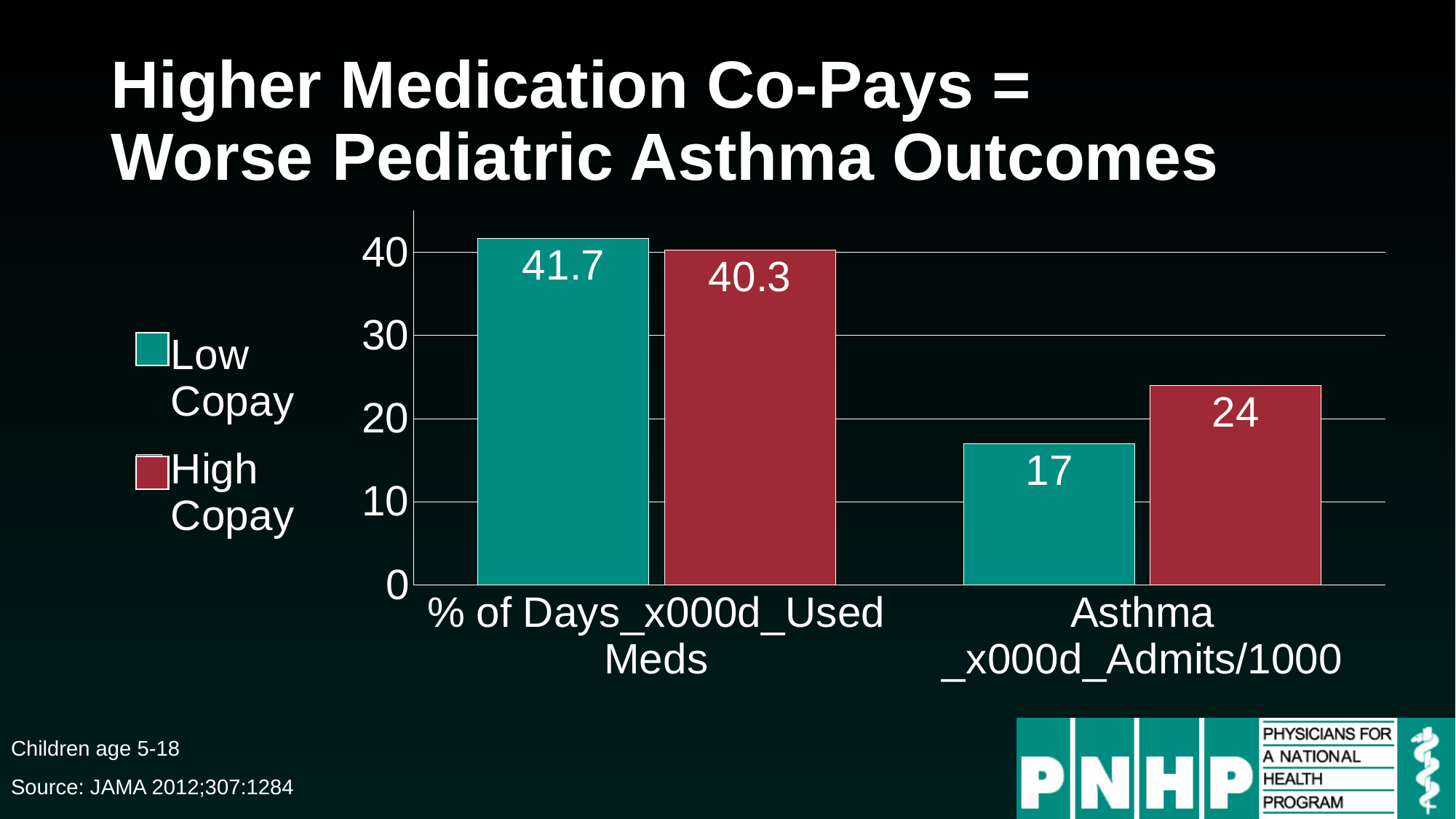
Which bar in the chart has the highest value? Low Copay, % of Days Used Meds (41.7) What is the difference between the Low Copay and High Copay values for % of Days Used Meds? 1.4 What colour represents the High Copay series? Red Which bar in the chart has the lowest value? Low Copay, Asthma Admits/1000 (17) What is the High Copay value for Asthma Admits/1000? 24 What is the Low Copay value for % of Days Used Meds? 41.7 What is the High Copay value for % of Days Used Meds? 40.3 How many series does the legend list? 2 What is the Low Copay value for Asthma Admits/1000? 17 Which group has the higher Asthma Admits/1000, Low Copay or High Copay? High Copay What type of chart is shown on the slide? Bar chart What is the difference between the High Copay and Low Copay values for Asthma Admits/1000? 7